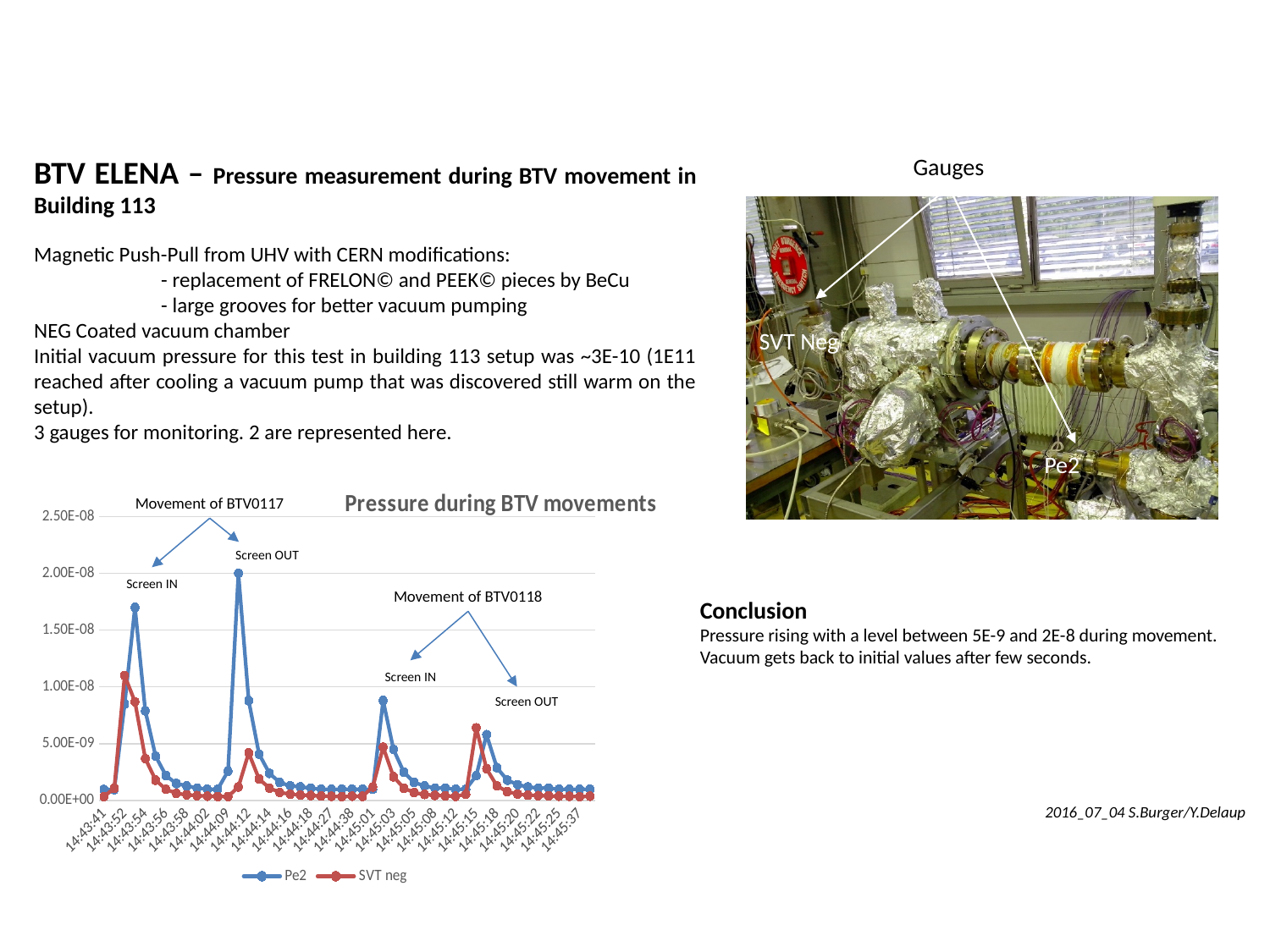
In the 'Pressure during BTV movements' chart, is the Pe2 peak at 'Screen IN' of BTV0118 greater or less than 1.00E-08? less What are the two series named in the legend of the 'Pressure during BTV movements' chart? Pe2 and SVT neg In the 'Pressure during BTV movements' chart, which series has the higher peak at 'Screen OUT' of BTV0118, Pe2 or SVT neg? SVT neg In the 'Pressure during BTV movements' chart, which series reaches the highest pressure value? Pe2 In the 'Pressure during BTV movements' chart, is the highest SVT neg peak greater or less than 1.50E-08? less In the 'Pressure during BTV movements' chart, is the Pe2 peak at 'Screen OUT' of BTV0117 greater or less than the Pe2 peak at 'Screen IN' of BTV0117? greater How many series does the legend of the 'Pressure during BTV movements' chart list? 2 In the 'Pressure during BTV movements' chart, which series has the higher peak at 'Screen OUT' of BTV0117, Pe2 or SVT neg? Pe2 In the 'Pressure during BTV movements' chart, is the Pe2 peak at 'Screen IN' of BTV0117 greater or less than 1.50E-08? greater What kind of chart is 'Pressure during BTV movements'? line chart In the 'Pressure during BTV movements' chart, which series is drawn in red? SVT neg